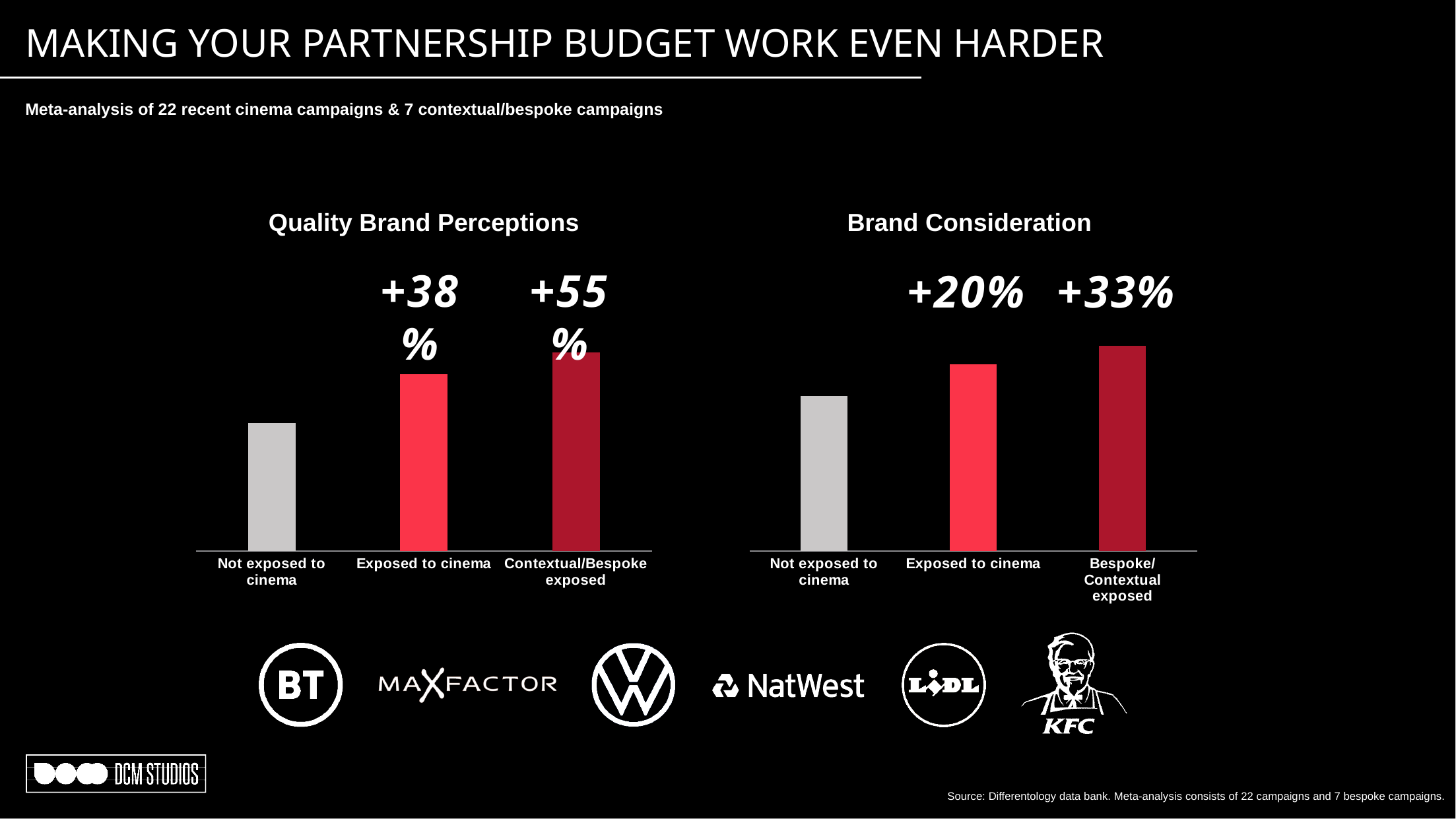
In the Quality Brand Perceptions chart, how many percentage points higher is the printed uplift for Contextual/Bespoke exposed than for Exposed to cinema? 17 In the Brand Consideration chart, how many percentage points higher is the printed uplift for Bespoke/Contextual exposed than for Exposed to cinema? 13 In the Quality Brand Perceptions chart, what colour is the Not exposed to cinema bar? Grey In the Brand Consideration chart, what uplift is printed above the Exposed to cinema bar? +20% In the Brand Consideration chart, which category has the shortest bar? Not exposed to cinema In the Quality Brand Perceptions chart, what uplift is printed above the Exposed to cinema bar? +38% In the Brand Consideration chart, which bar is taller: Exposed to cinema or Bespoke/Contextual exposed? Bespoke/Contextual exposed How many categories are shown in the Quality Brand Perceptions chart? 3 In the Brand Consideration chart, what uplift is printed above the Bespoke/Contextual exposed bar? +33% What type of chart is the Brand Consideration chart? Bar chart In the Quality Brand Perceptions chart, what uplift is printed above the Contextual/Bespoke exposed bar? +55% In the Quality Brand Perceptions chart, which category has the tallest bar? Contextual/Bespoke exposed